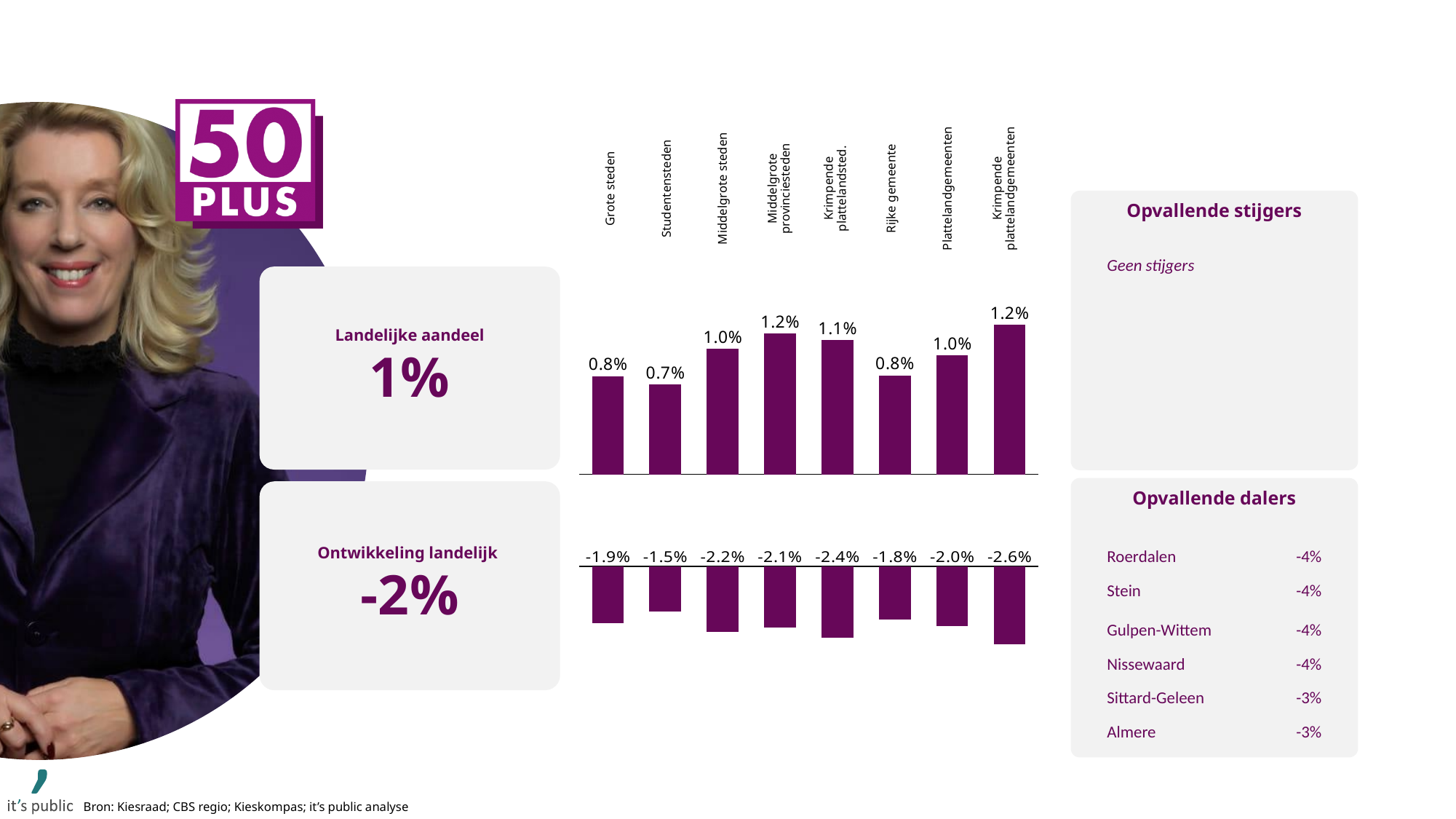
In the bottom chart, what is the difference between the values for Studentensteden and Krimpende plattelandgemeenten? 1.1% How many categories does the top chart show? 8 In the top chart, what is the difference between the values for Middelgrote provinciesteden and Grote steden? 0.4% In the bottom chart, what is the value for Krimpende plattelandgemeenten? -2.6% In the top chart, what is the value for Studentensteden? 0.7% In the bottom chart, which category has the highest value? Studentensteden In the top chart, which category has the lowest value? Studentensteden In the bottom chart, which category has the lowest value? Krimpende plattelandgemeenten In the top chart, what is the value for Krimpende plattelandsted.? 1.1% In the bottom chart, what is the value for Rijke gemeente? -1.8% What kind of chart is the bottom chart? Bar chart In the bottom chart, which is larger, the value for Grote steden or the value for Middelgrote steden? Grote steden